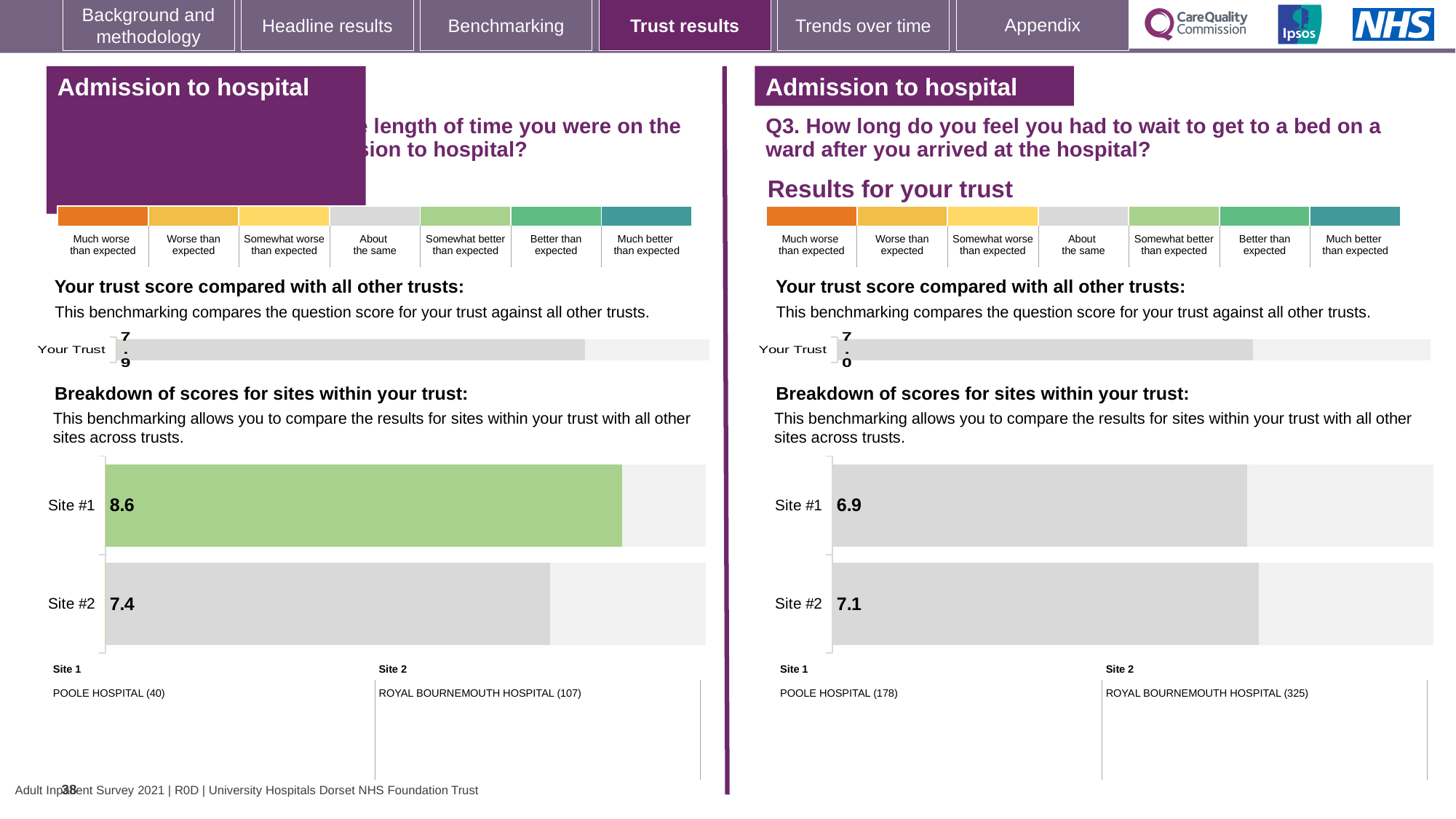
In the right-hand panel (Q3) breakdown of scores for sites within your trust, what is the score for Site #2? 7.1 In the left-hand panel's breakdown of scores for sites within your trust, what is the score for Site #1? 8.6 In the right-hand panel (Q3) site breakdown chart, what is the difference between the Site #2 and Site #1 scores? 0.2 In the left-hand panel's 'Your trust score compared with all other trusts' chart, what is the score shown for Your Trust? 7.9 How many sites are shown in the right-hand panel (Q3) site breakdown chart? 2 In the left-hand panel's site breakdown chart, which site has the higher score? Site #1 In the right-hand panel (Q3) breakdown of scores for sites within your trust, what is the score for Site #1? 6.9 What type of chart is used for the site breakdown in the left-hand panel? Bar chart In the right-hand panel (Q3) site breakdown chart, which site has the lower score? Site #1 In the right-hand panel (Q3) 'Your trust score compared with all other trusts' chart, what is the score shown for Your Trust? 7.0 In the left-hand panel's breakdown of scores for sites within your trust, what is the score for Site #2? 7.4 In the left-hand panel's site breakdown chart, what is the difference between the Site #1 and Site #2 scores? 1.2